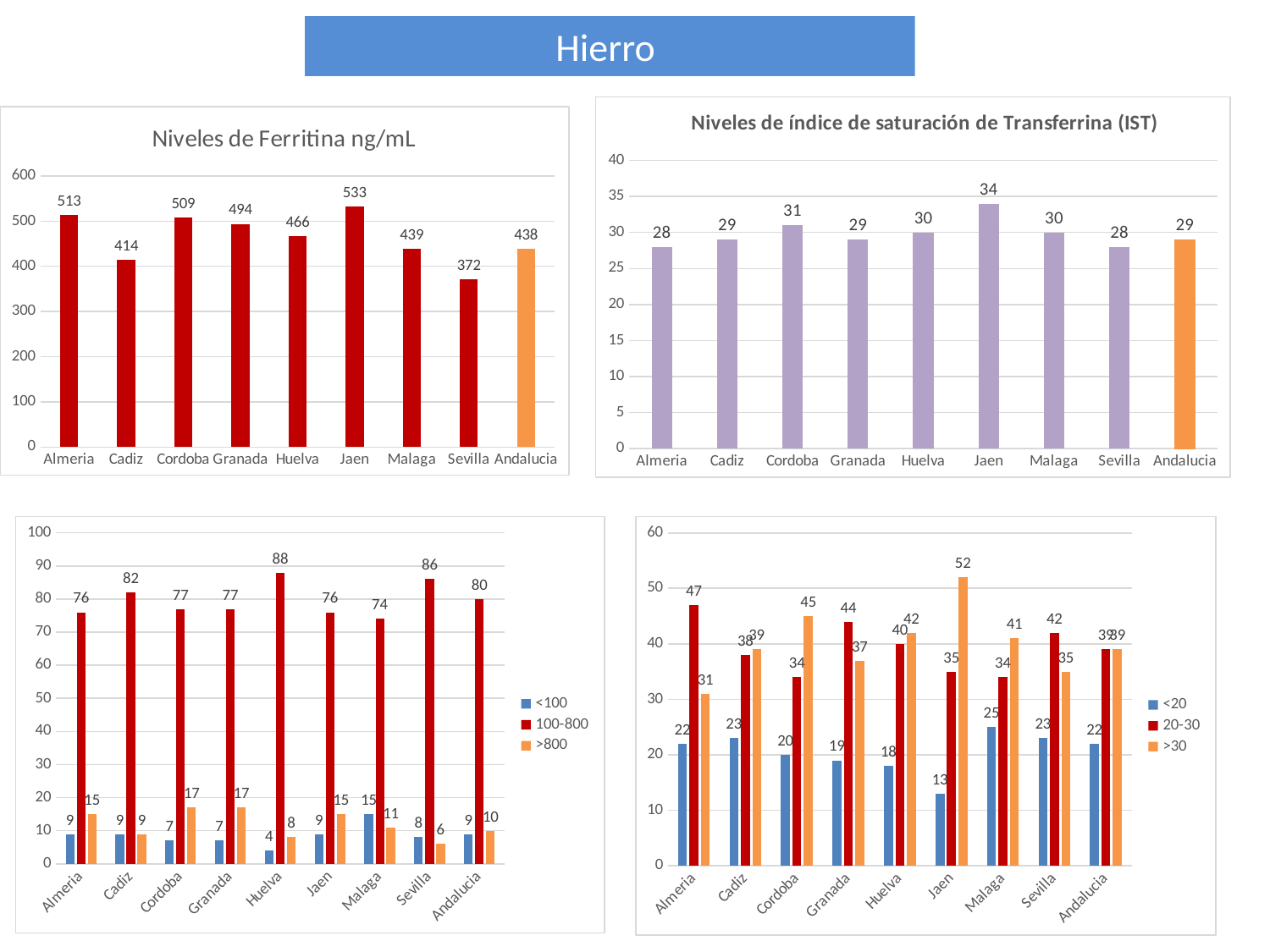
In the bottom-left chart, what is the value of the '100-800' series for Huelva? 88 In the bottom-right chart, what is the value of the '>30' series for Jaen? 52 In the 'Niveles de Ferritina ng/mL' chart, what is the value for Jaen? 533 What kind of chart is the bottom-right chart? Bar chart In the 'Niveles de índice de saturación de Transferrina (IST)' chart, which is larger, the value for Huelva or the value for Sevilla? Huelva In the bottom-left chart, what is the value of the '>800' series for Sevilla? 6 In the 'Niveles de Ferritina ng/mL' chart, which category has the lowest value? Sevilla In the 'Niveles de Ferritina ng/mL' chart, how many categories are shown on the x axis? 9 In the bottom-left chart, how many series does the legend list? 3 In the 'Niveles de índice de saturación de Transferrina (IST)' chart, which category has the highest value? Jaen In the 'Niveles de Ferritina ng/mL' chart, what is the difference between the values for Almeria and Cadiz? 99 In the 'Niveles de índice de saturación de Transferrina (IST)' chart, what is the value for Cordoba? 31